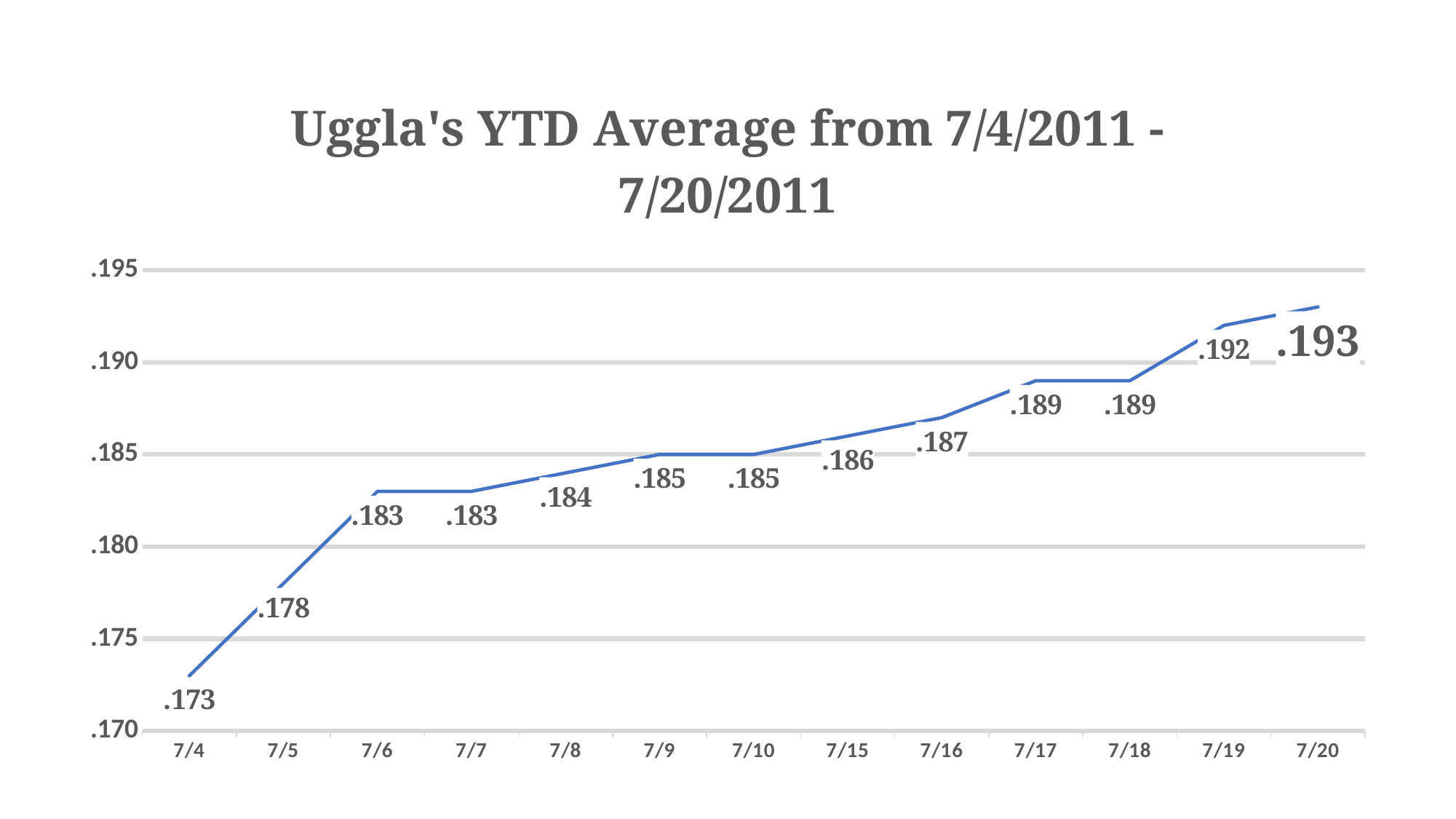
How many dates are plotted on the x axis? 13 What is the title of the chart? Uggla's YTD Average from 7/4/2011 - 7/20/2011 What is the YTD average on 7/20? .193 On which date is the YTD average lowest? 7/4 What kind of chart is shown? line chart On which date is the YTD average highest? 7/20 Does the YTD average rise or fall from 7/4 to 7/20? rise What is the YTD average on 7/16? .187 Which is larger, the YTD average on 7/5 or on 7/9? 7/9 What is the difference between the YTD average on 7/20 and on 7/4? .020 What is the YTD average on 7/4? .173 Is the YTD average on 7/19 greater or less than .190? greater